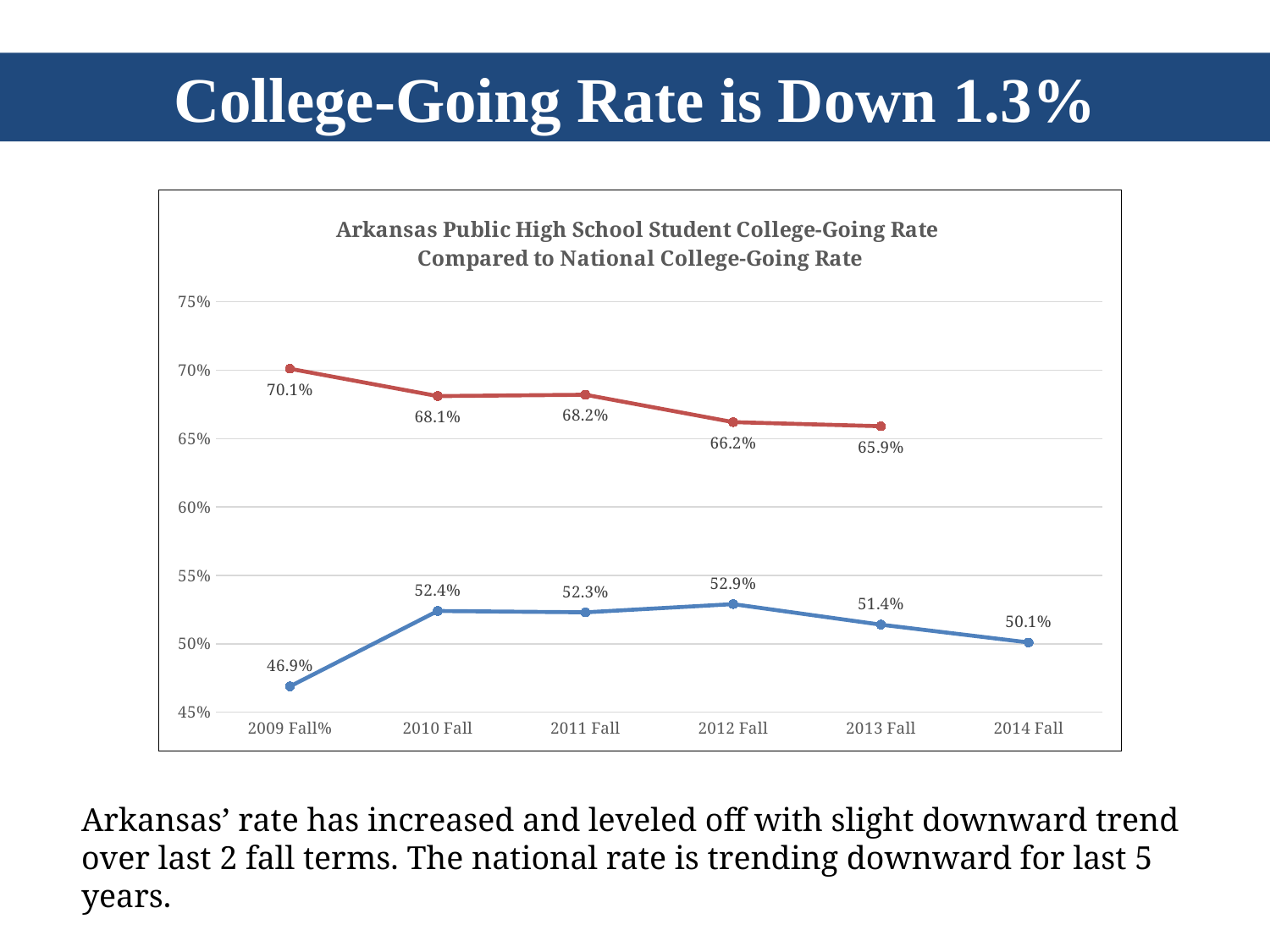
What is the value of the red line at 2009 Fall? 70.1% What is the difference between the red line's value and the blue line's value at 2009 Fall? 23.2% How many fall terms are shown on the x axis? 6 What is the value of the blue line at 2014 Fall? 50.1% What is the difference between the blue line's values at 2013 Fall and 2014 Fall? 1.3% What is the value of the red line at 2013 Fall? 65.9% Which is larger: the red line's value at 2012 Fall or its value at 2013 Fall? 2012 Fall At which fall term does the blue line reach its lowest value? 2009 Fall Does the red line rise or fall from 2009 Fall to 2013 Fall? Fall What type of chart is shown on the slide? Line chart At which fall term does the blue line reach its highest value? 2012 Fall What is the value of the blue line at 2012 Fall? 52.9%